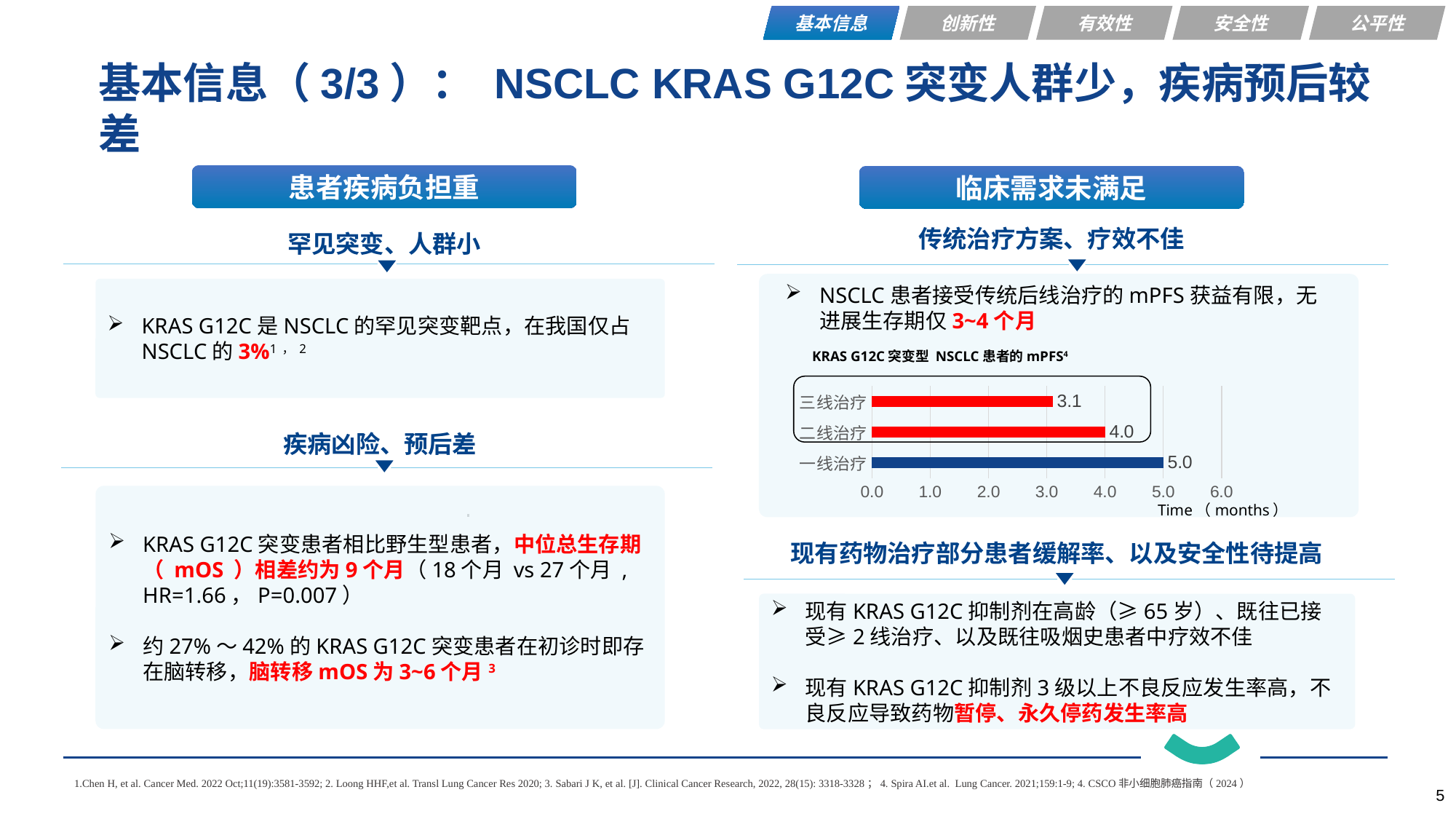
What is the title of the chart? KRAS G12C 突变型 NSCLC 患者的 mPFS What is the difference in mPFS between 二线治疗 and 三线治疗? 0.9 Which treatment line has the highest mPFS in the chart? 一线治疗 Which has a larger mPFS, 二线治疗 or 三线治疗? 二线治疗 What is the label of the x axis of the chart? Time（months） What kind of chart is used to show the mPFS data? Bar chart What is the difference in mPFS between 一线治疗 and 三线治疗? 1.9 Which treatment line has the lowest mPFS in the chart? 三线治疗 What is the mPFS value for 一线治疗 in the chart? 5.0 How many treatment lines are shown in the chart? 3 What is the mPFS value for 二线治疗 in the chart? 4.0 What is the mPFS value for 三线治疗 in the chart? 3.1